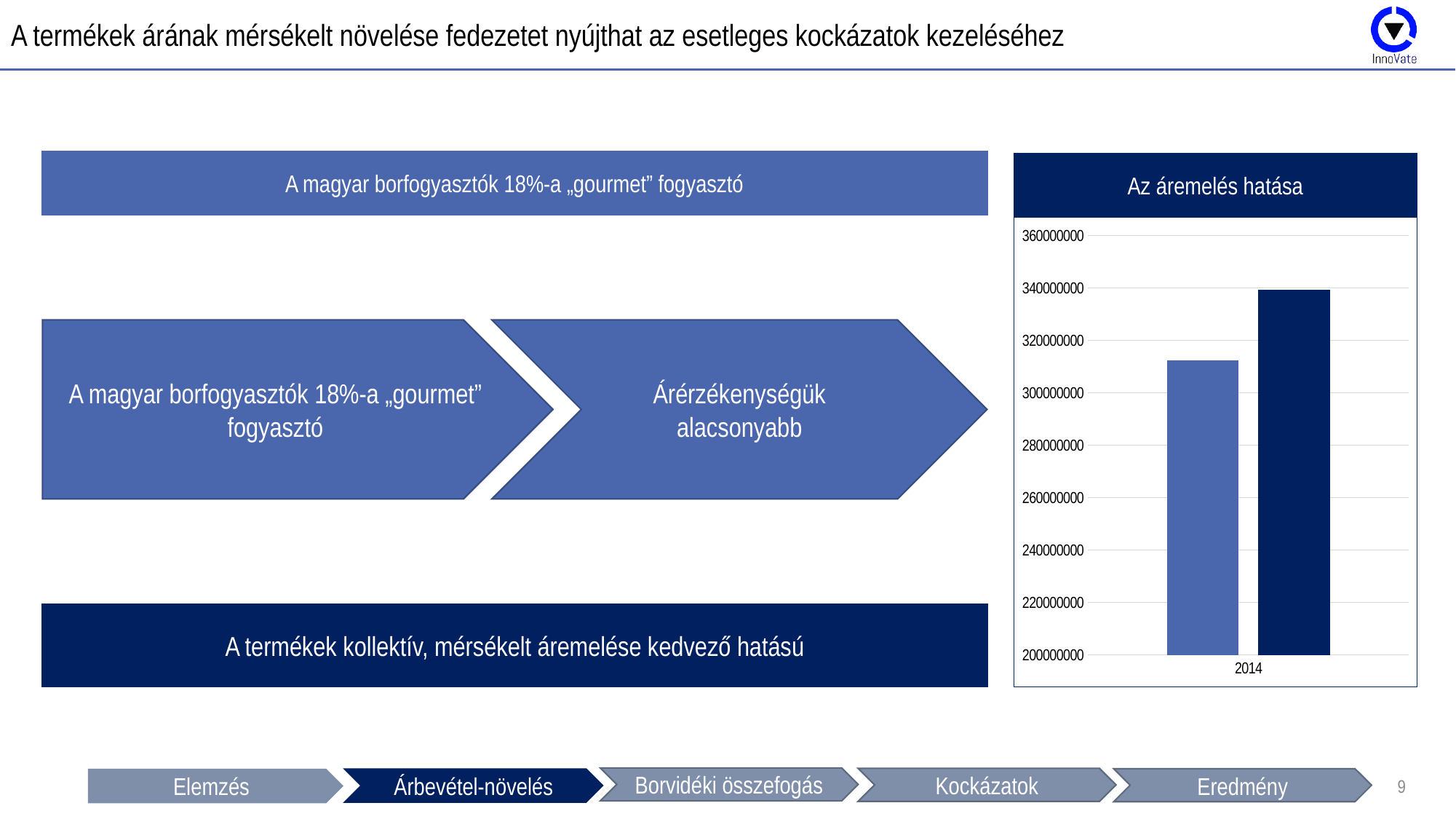
What is the lowest value shown on the y axis of the chart? 200000000 Is the value of the dark blue bar greater or less than 320000000? greater How many bars are plotted in the chart? 2 Which bar is taller in the chart, the light blue bar or the dark blue bar? the dark blue bar Is the value of the light blue bar greater or less than 320000000? less What kind of chart is shown under the title "Az áremelés hatása"? bar chart Is the value of the light blue bar greater or less than 300000000? greater What is the title of the chart on the right side of the slide? Az áremelés hatása Which year is labelled on the x axis of the chart? 2014 How many categories are shown on the x axis of the chart? 1 What is the highest value shown on the y axis of the chart? 360000000